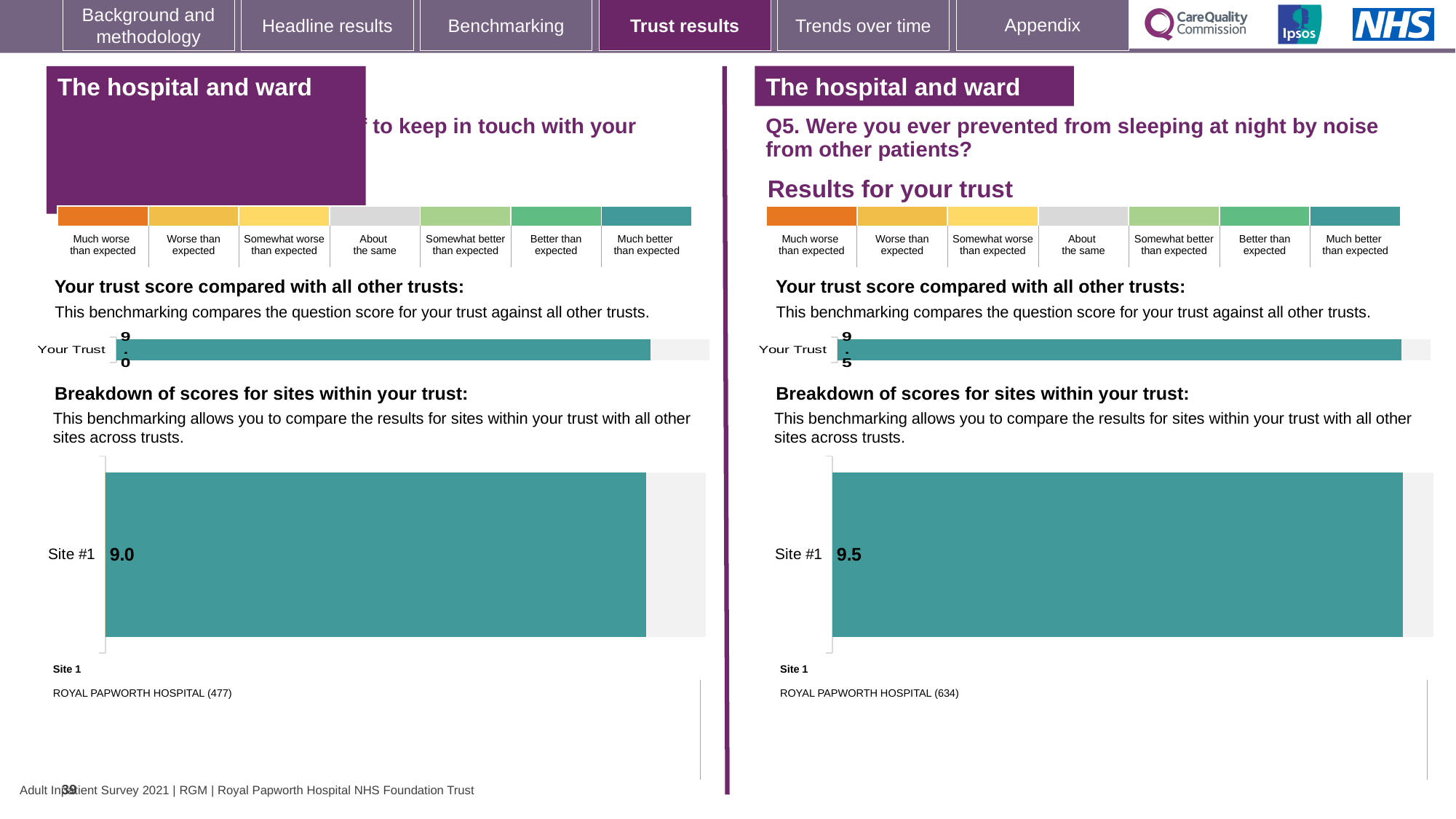
On the right-hand 'Your trust score compared with all other trusts' chart (Q5, prevented from sleeping by noise from other patients), what is the score shown for Your Trust? 9.5 On the right-hand 'Breakdown of scores for sites within your trust' chart (Q5), what is the score for Site #1? 9.5 What type of chart is used for the 'Breakdown of scores for sites within your trust' on the right-hand side? Bar chart On the left-hand 'Your trust score compared with all other trusts' chart, what is the score shown for Your Trust? 9.0 How many sites are plotted on the left-hand 'Breakdown of scores for sites within your trust' chart? 1 What is the difference between the Site #1 score on the right-hand (Q5) breakdown chart and the Site #1 score on the left-hand breakdown chart? 0.5 Which site name is listed under Site 1 on the right-hand (Q5) breakdown chart? ROYAL PAPWORTH HOSPITAL (634) On the left-hand 'Breakdown of scores for sites within your trust' chart, what is the score for Site #1? 9.0 Is the Your Trust score on the right-hand (Q5) trust comparison chart greater or less than 9? greater Which is larger: the Site #1 score on the left-hand breakdown chart or the Site #1 score on the right-hand (Q5) breakdown chart? Right-hand (Q5) chart, 9.5 Which site name is listed under Site 1 on the left-hand breakdown chart? ROYAL PAPWORTH HOSPITAL (477) How many sites are plotted on the right-hand (Q5) 'Breakdown of scores for sites within your trust' chart? 1